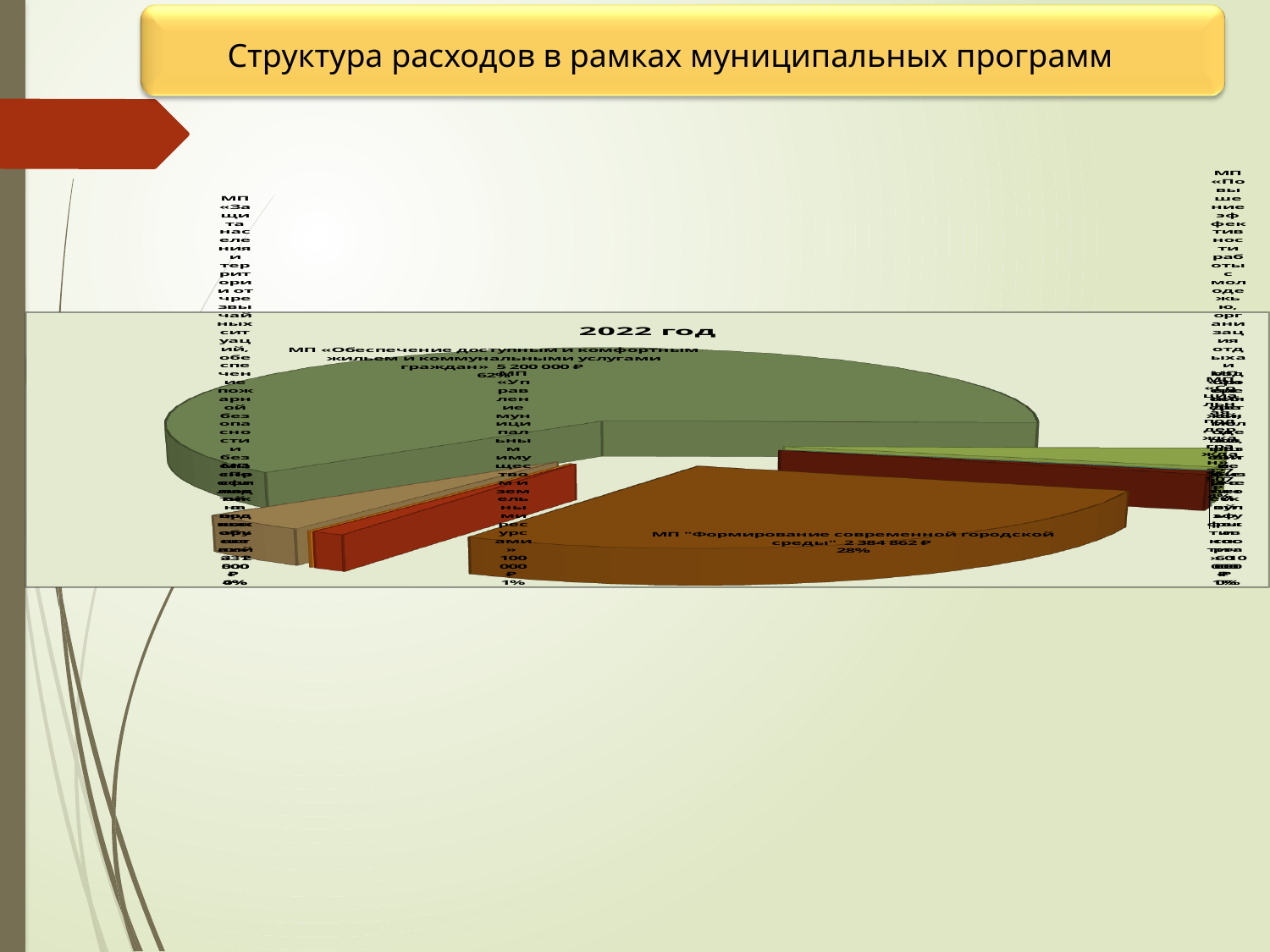
What is the title of the chart? 2022 год What is the value shown for МП «Обеспечение доступным и комфортным жильем и коммунальными услугами граждан»? 5 200 000 ₽ What share of the pie does МП «Обеспечение доступным и комфортным жильем и коммунальными услугами граждан» have? 62% What is the value shown for МП «Управление муниципальным имуществом и земельными ресурсами»? 100 000 ₽ Which is larger: the slice for МП «Обеспечение доступным и комфортным жильем и коммунальными услугами граждан» or the slice for МП "Формирование современной городской среды"? МП «Обеспечение доступным и комфортным жильем и коммунальными услугами граждан» By how many rubles does the value for МП «Обеспечение доступным и комфортным жильем и коммунальными услугами граждан» exceed the value for МП "Формирование современной городской среды"? 2 815 138 ₽ What is the title of the slide above the chart? Структура расходов в рамках муниципальных программ What is the value shown for МП "Формирование современной городской среды"? 2 384 862 ₽ What kind of chart is shown on the slide? pie chart What is the difference in percentage points between the share of МП «Обеспечение доступным и комфортным жильем и коммунальными услугами граждан» and the share of МП "Формирование современной городской среды"? 34% Which program has the largest slice of the pie? МП «Обеспечение доступным и комфортным жильем и коммунальными услугами граждан» What share of the pie does МП "Формирование современной городской среды" have? 28%